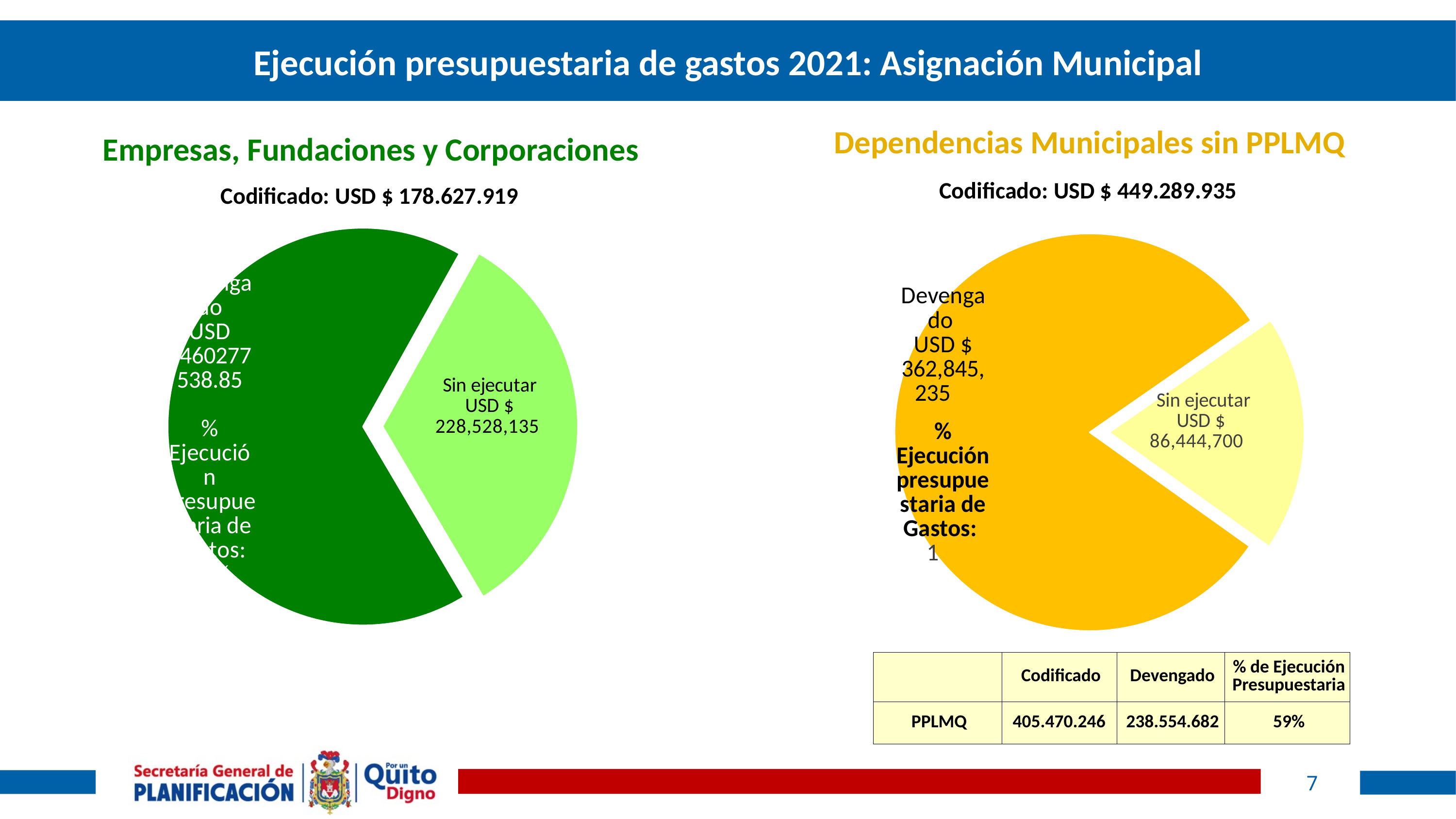
What colour is the 'Sin ejecutar' slice in the 'Dependencias Municipales sin PPLMQ' pie chart? Light yellow In the 'Empresas, Fundaciones y Corporaciones' pie chart, which slice is larger, 'Devengado' or 'Sin ejecutar'? Devengado In the 'Dependencias Municipales sin PPLMQ' pie chart, what is the difference between the 'Devengado' and 'Sin ejecutar' values? USD $ 276,400,535 What is the title of the pie chart on the left side of the slide? Empresas, Fundaciones y Corporaciones In the 'Dependencias Municipales sin PPLMQ' pie chart, what is the sum of the 'Devengado' and 'Sin ejecutar' slices? USD $ 449,289,935 In the 'Dependencias Municipales sin PPLMQ' pie chart, which slice is the smallest? Sin ejecutar In the 'Dependencias Municipales sin PPLMQ' pie chart, what is the value of the 'Sin ejecutar' slice? USD $ 86,444,700 In the 'Dependencias Municipales sin PPLMQ' pie chart, which slice is larger, 'Devengado' or 'Sin ejecutar'? Devengado In the 'Empresas, Fundaciones y Corporaciones' pie chart, what is the value of the 'Sin ejecutar' slice? USD $ 228,528,135 How many slices does the 'Empresas, Fundaciones y Corporaciones' pie chart have? 2 What kind of chart is used for 'Dependencias Municipales sin PPLMQ'? Pie chart In the 'Dependencias Municipales sin PPLMQ' pie chart, what is the value of the 'Devengado' slice? USD $ 362,845,235